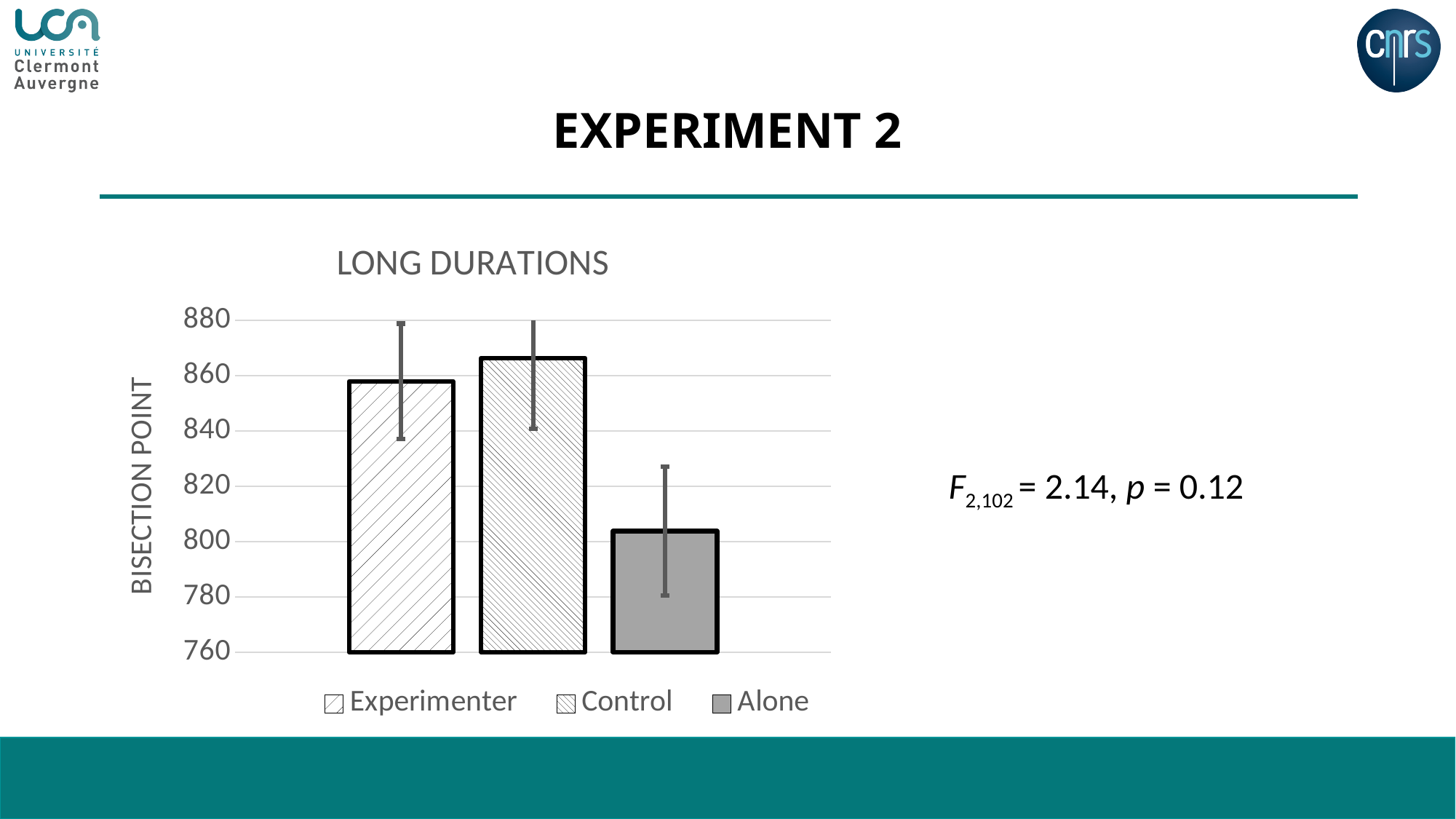
What kind of chart is shown on the slide? bar chart Which has a larger bisection point, Control or Alone? Control How many series does the legend list? 3 What is the label of the vertical axis? BISECTION POINT Is the value for Alone greater or less than 820? less Is the value for Control greater or less than 880? less Which has a larger bisection point, Experimenter or Alone? Experimenter Which condition has the lowest bisection point? Alone Which condition has the highest bisection point? Control Is the value for Experimenter greater or less than 840? greater How many bars are plotted in the chart? 3 What is the title of the chart? LONG DURATIONS